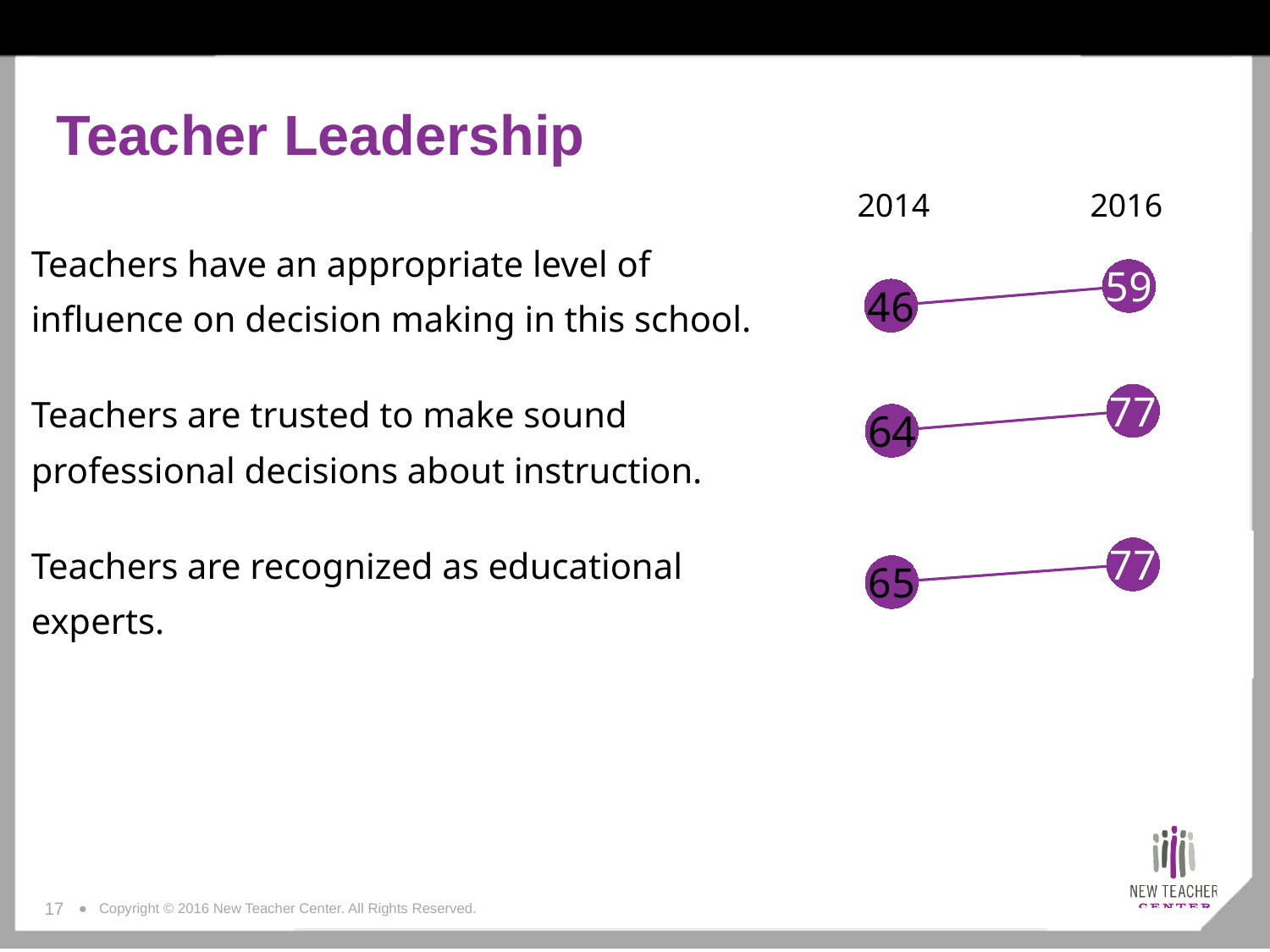
By how much did the value for "Teachers are recognized as educational experts" change from 2014 to 2016? 12 What was the 2016 value for "Teachers are trusted to make sound professional decisions about instruction"? 77 What was the 2016 value for "Teachers have an appropriate level of influence on decision making in this school"? 59 What was the 2016 value for "Teachers are recognized as educational experts"? 77 By how much did the value for "Teachers have an appropriate level of influence on decision making in this school" change from 2014 to 2016? 13 Did the value for "Teachers are trusted to make sound professional decisions about instruction" rise or fall from 2014 to 2016? rise What was the 2014 value for "Teachers have an appropriate level of influence on decision making in this school"? 46 Which statement had the lowest value in 2014? Teachers have an appropriate level of influence on decision making in this school. What was the 2014 value for "Teachers are recognized as educational experts"? 65 What was the 2014 value for "Teachers are trusted to make sound professional decisions about instruction"? 64 Which two years are compared in the charts? 2014 and 2016 How many statements have values plotted on the slide? 3